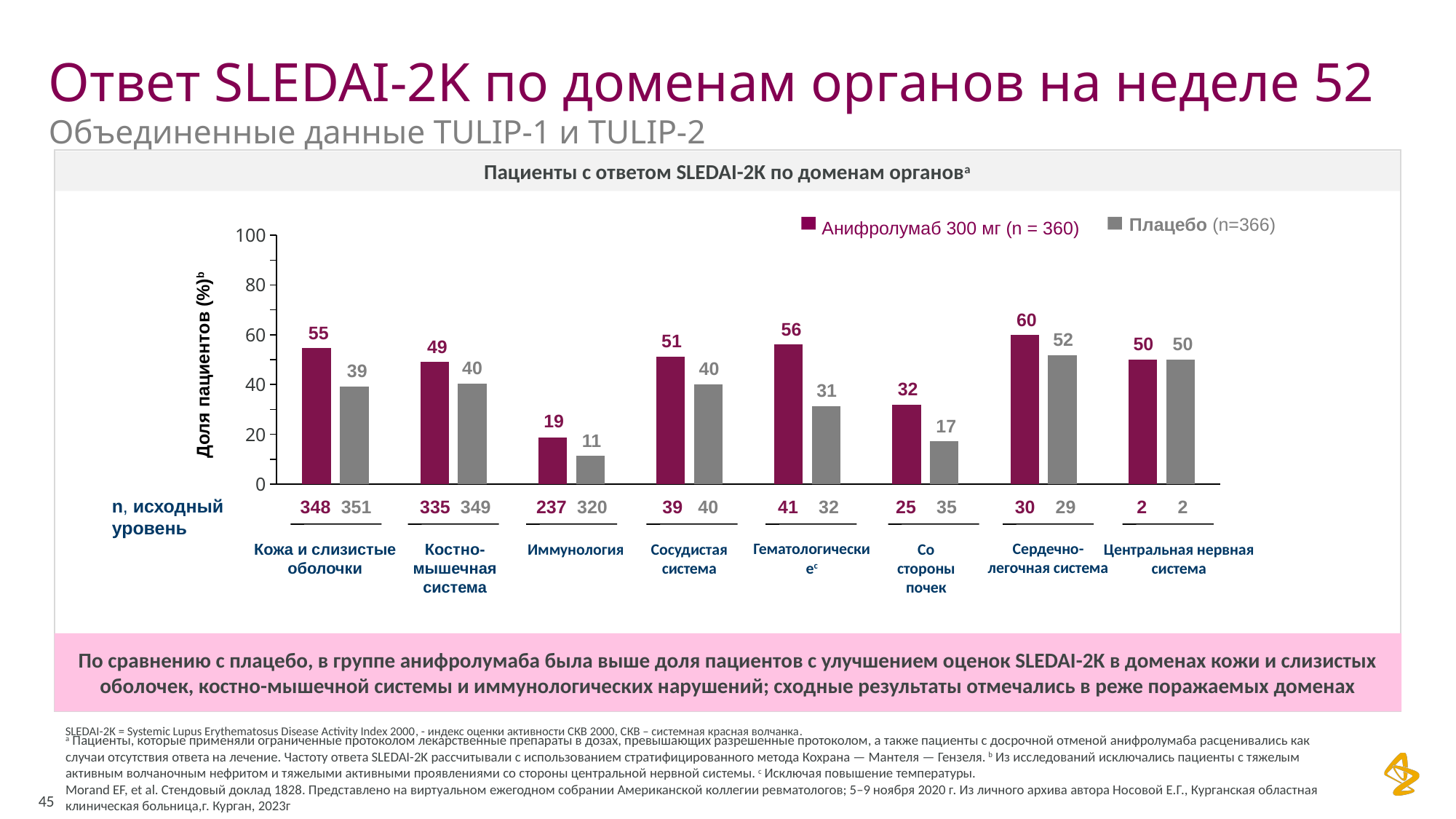
In which domain is the Анифролумаб 300 мг value the highest? Сердечно-легочная система What is the value for Плацебо in the Гематологические domain? 31 In which domain is the Плацебо value the lowest? Иммунология How many organ domain categories are shown on the x axis? 8 What colour are the bars for Анифролумаб 300 мг? Dark magenta (purple-red) What type of chart is shown on the slide? Bar chart Is the Плацебо value for Со стороны почек greater or less than 20? less What is the baseline n for Плацебо in the Иммунология domain? 320 What is the difference between the Анифролумаб 300 мг and Плацебо values in the Гематологические domain? 25 What is the value for Анифролумаб 300 мг in the Иммунология domain? 19 Which is larger in the Кожа и слизистые оболочки domain: the Анифролумаб 300 мг value or the Плацебо value? Анифролумаб 300 мг How many series does the legend list? 2